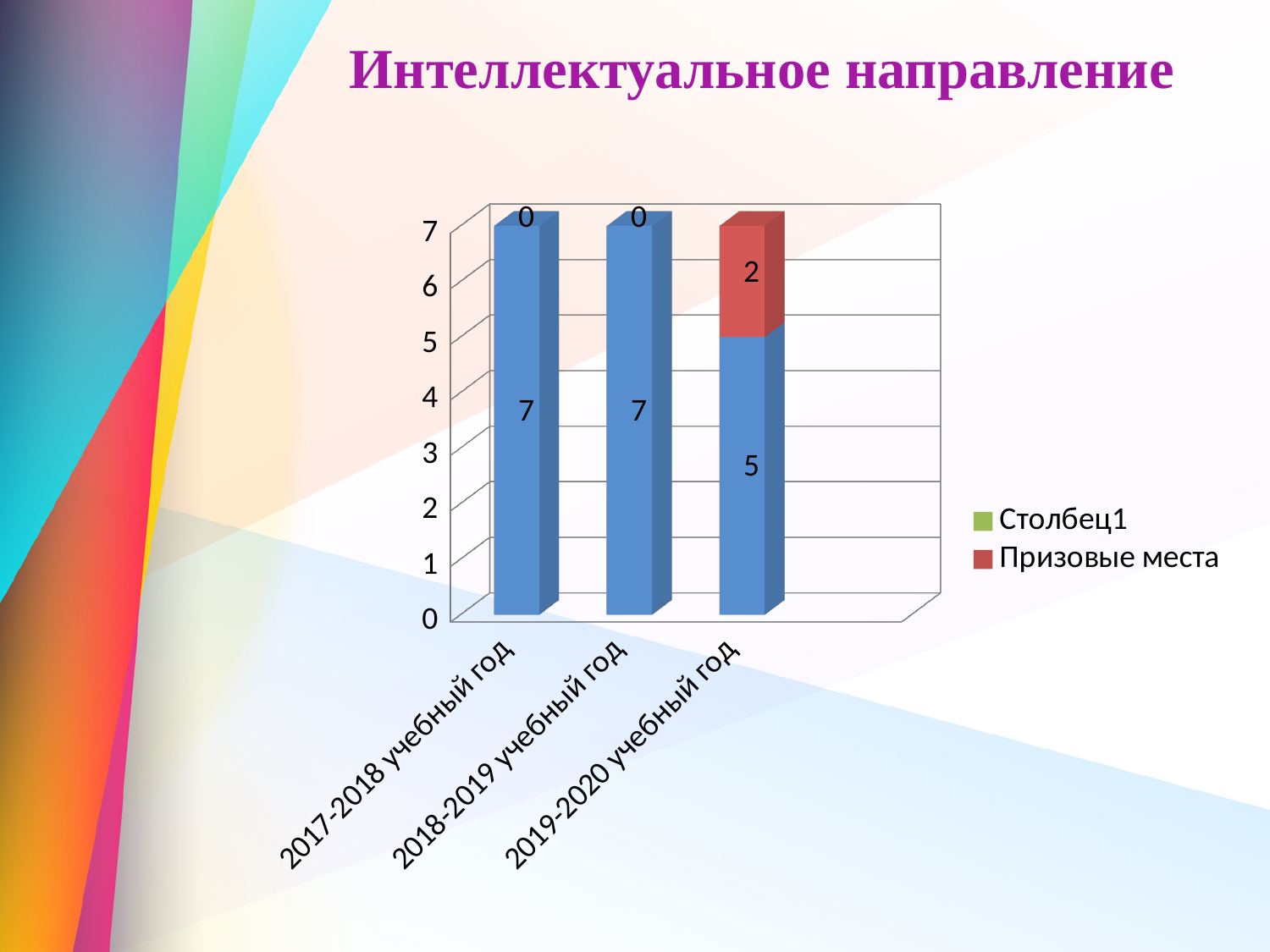
What kind of chart is shown on the slide? bar chart What is the value of the Призовые места segment for 2019-2020 учебный год? 2 Which school year has the highest value for Призовые места? 2019-2020 учебный год How many entries does the legend list? 2 Which school year has the lowest value for the blue segment? 2019-2020 учебный год How many categories (school years) are shown on the x axis? 3 What is the value of the blue segment for 2019-2020 учебный год? 5 What is the difference between the blue segment values for 2017-2018 учебный год and 2019-2020 учебный год? 2 What is the total of the stacked bar for 2019-2020 учебный год? 7 What is the title of the slide? Интеллектуальное направление What is the value of the Призовые места segment for 2017-2018 учебный год? 0 What is the value of the blue segment for 2018-2019 учебный год? 7